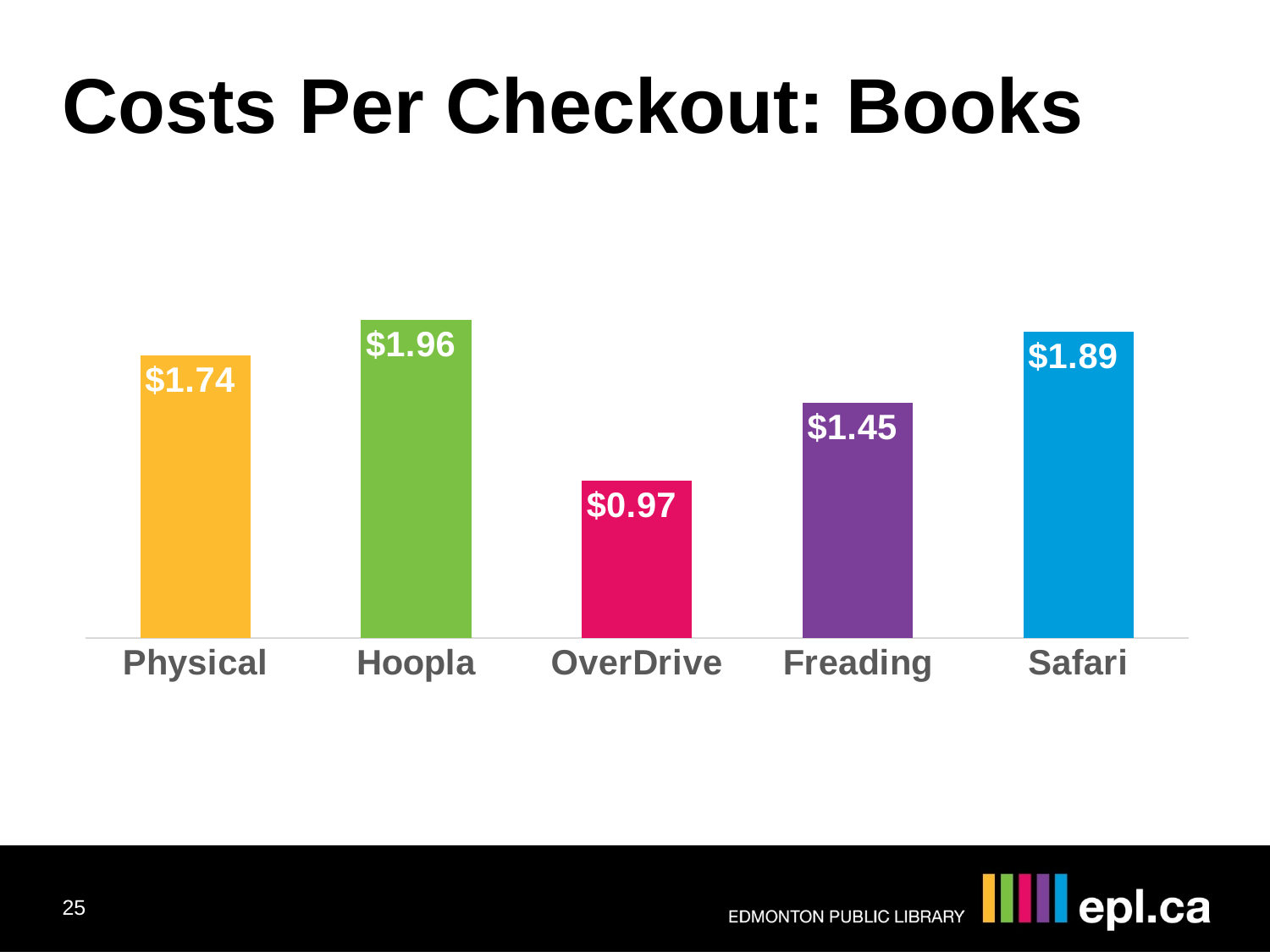
Which category has the lowest cost per checkout? OverDrive Which has a higher cost per checkout, Physical or OverDrive? Physical How many categories are shown in the chart? 5 What is the difference between the cost per checkout for Safari and Physical? $0.15 What kind of chart is shown on the slide? Bar chart Which category has the highest cost per checkout? Hoopla Which has a higher cost per checkout, Freading or Safari? Safari What is the difference between the cost per checkout for Hoopla and OverDrive? $0.99 What is the cost per checkout for OverDrive? $0.97 What is the title of the slide? Costs Per Checkout: Books What is the cost per checkout for Physical books? $1.74 What is the cost per checkout for Freading? $1.45